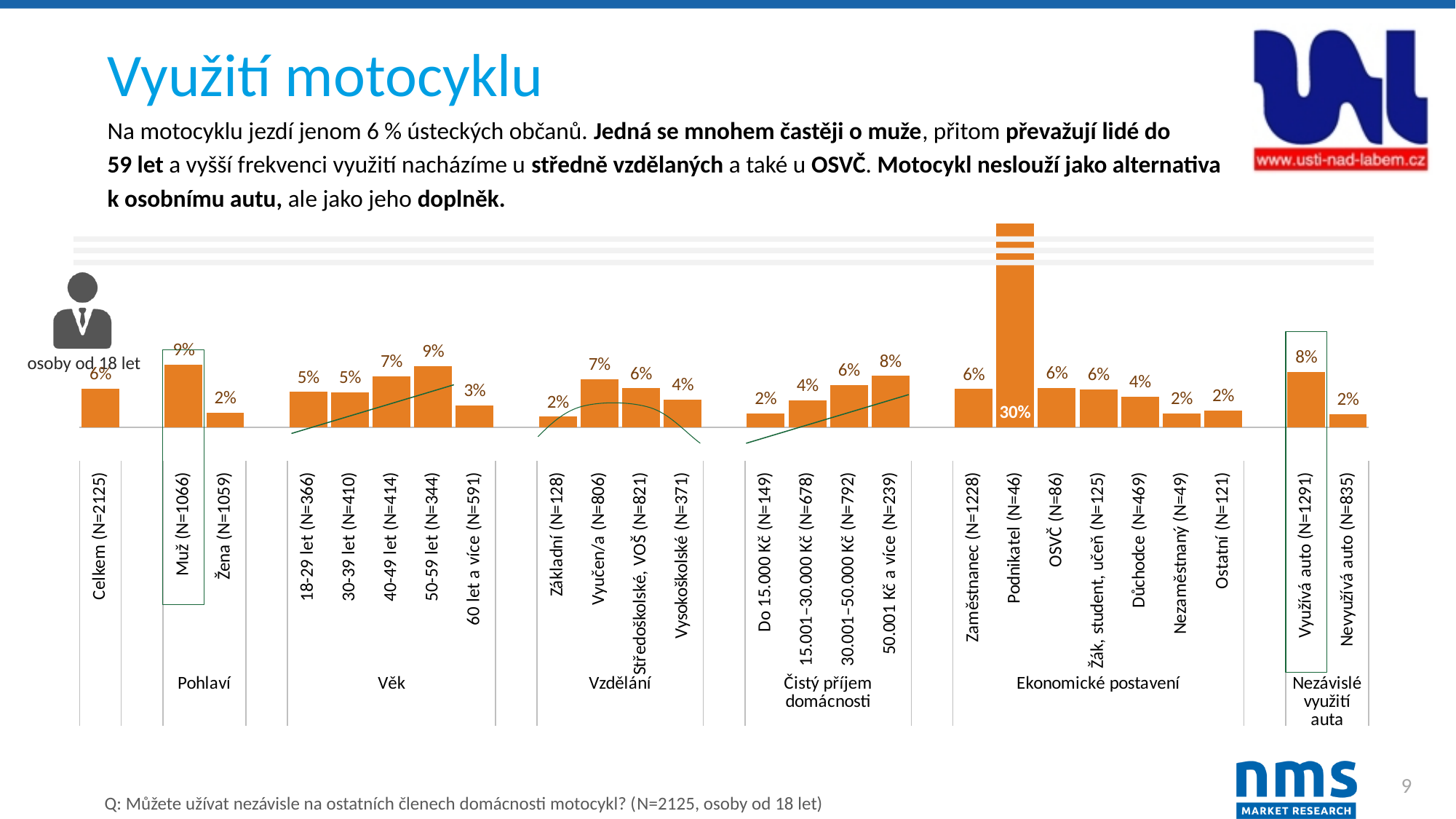
Which category has the highest value in the chart? Podnikatel (N=46) What is the value for Muž (N=1066)? 9% Within the Věk group, which category has the lowest value? 60 let a více (N=591) How many bars are plotted in the chart? 25 Which is larger, the value for Vyučen/a (N=806) or the value for Vysokoškolské (N=371)? Vyučen/a (N=806) What is the difference between the values for Muž (N=1066) and Žena (N=1059)? 7% Do the values rise or fall across the Čistý příjem domácnosti categories from Do 15.000 Kč to 50.001 Kč a více? rise What is the value for Využívá auto (N=1291)? 8% What kind of chart is shown on the slide? bar chart What is the difference between the values for Využívá auto (N=1291) and Nevyužívá auto (N=835)? 6% What is the value for Podnikatel (N=46)? 30% What is the value for Celkem (N=2125)? 6%